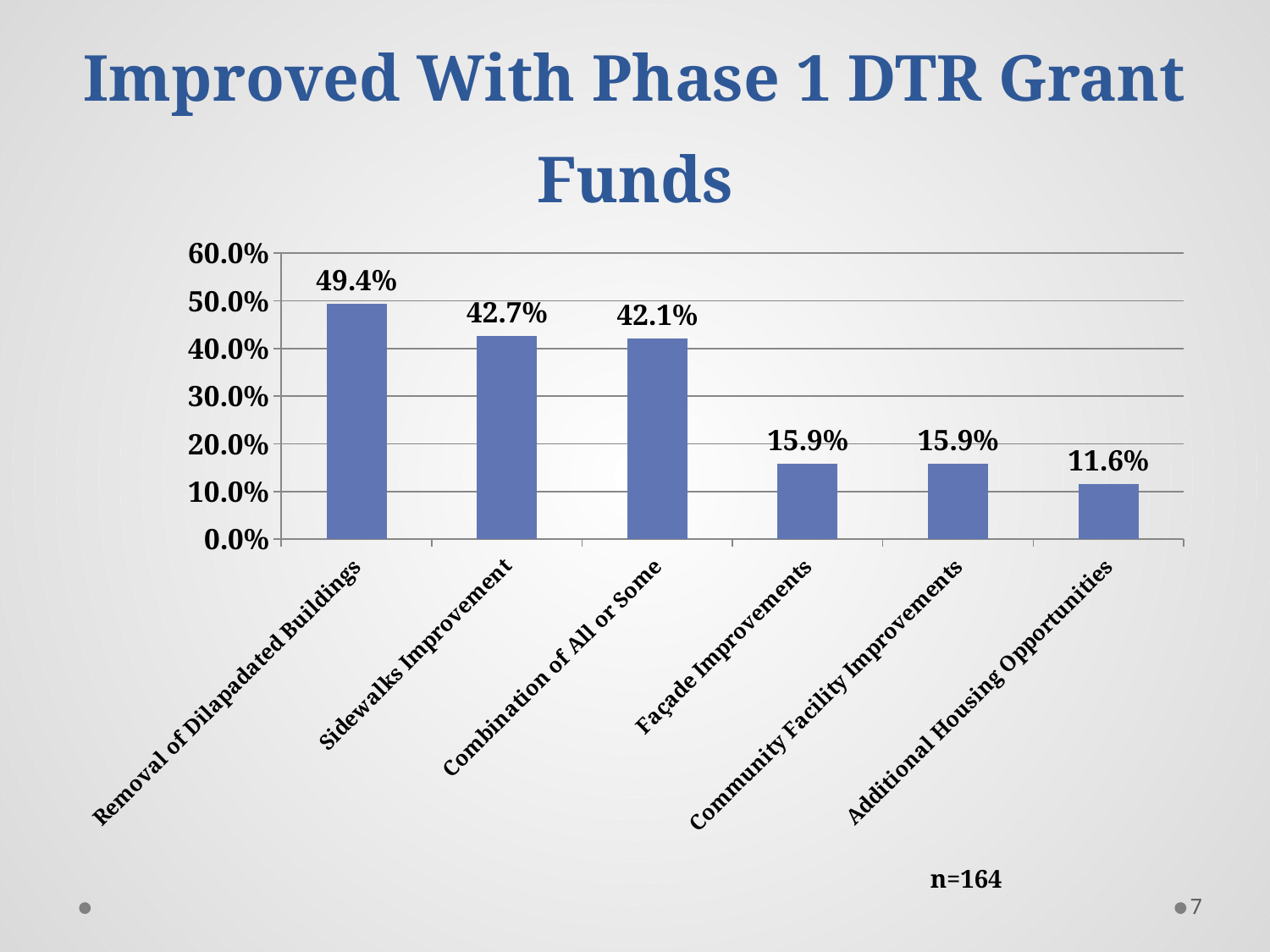
Is the value for Façade Improvements greater or less than 20.0%? less What is the difference between Façade Improvements and Additional Housing Opportunities? 4.3% What is the difference between Removal of Dilapadated Buildings and Sidewalks Improvement? 6.7% What sample size (n) is noted below the chart? n=164 What percentage is shown for Additional Housing Opportunities? 11.6% Which category has the lowest value? Additional Housing Opportunities How many categories are shown in the chart? 6 Which is larger, Combination of All or Some or Community Facility Improvements? Combination of All or Some Which category has the highest value? Removal of Dilapadated Buildings What type of chart is shown on the slide? bar chart What is the value for Sidewalks Improvement? 42.7% What percentage is shown for Removal of Dilapadated Buildings? 49.4%